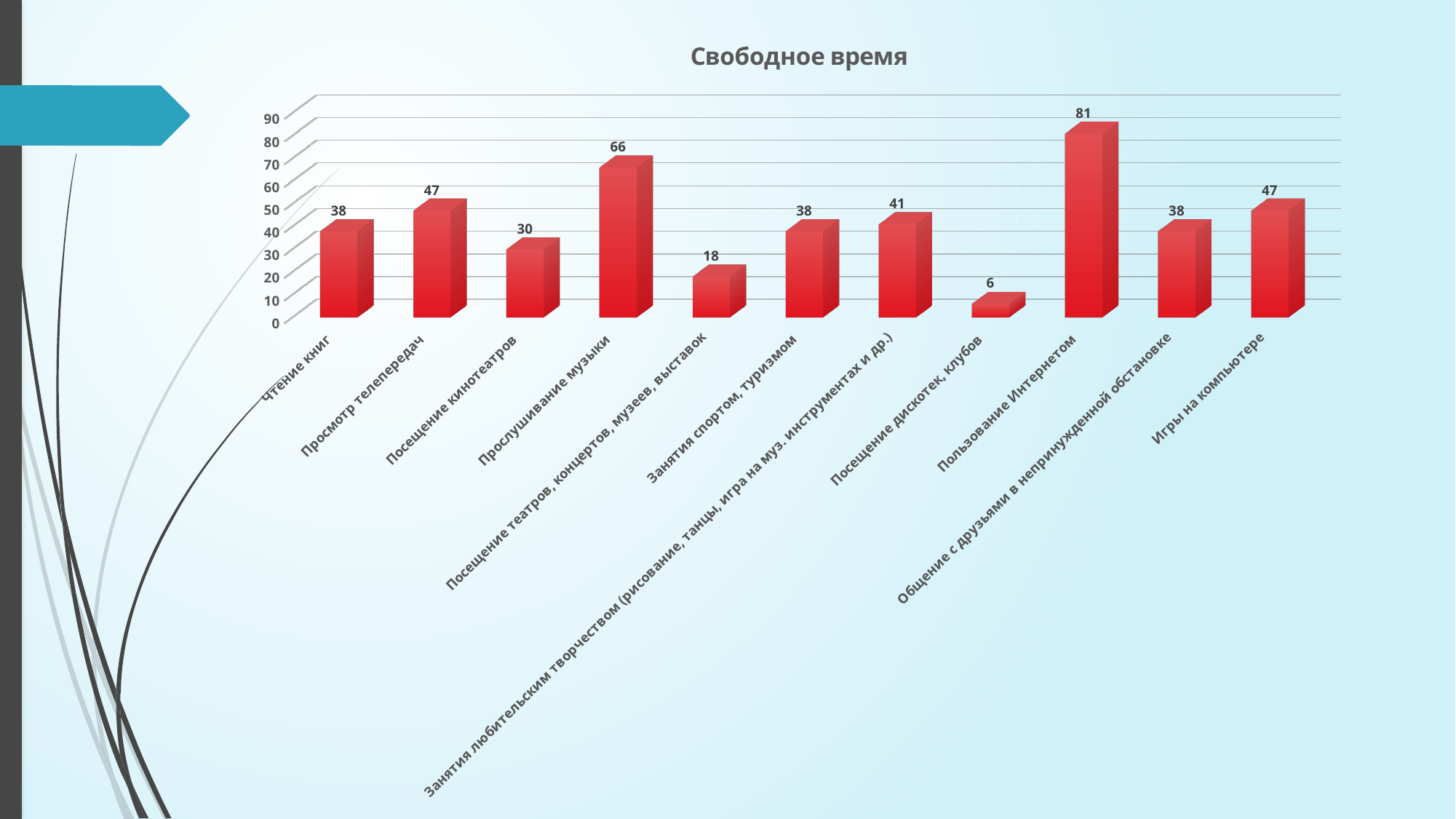
What is the value for Посещение кинотеатров? 30 What is the difference between the values for Просмотр телепередач and Посещение кинотеатров? 17 How many categories are shown in the chart? 11 Which category has the highest value? Пользование Интернетом Which is larger, the value for Занятия любительским творчеством or the value for Занятия спортом, туризмом? Занятия любительским творчеством What is the value for Прослушивание музыки? 66 What is the value for Пользование Интернетом? 81 What kind of chart is this? Bar chart What is the value for Посещение театров, концертов, музеев, выставок? 18 What is the difference between the values for Пользование Интернетом and Прослушивание музыки? 15 Which category has the lowest value? Посещение дискотек, клубов What is the title of the chart? Свободное время